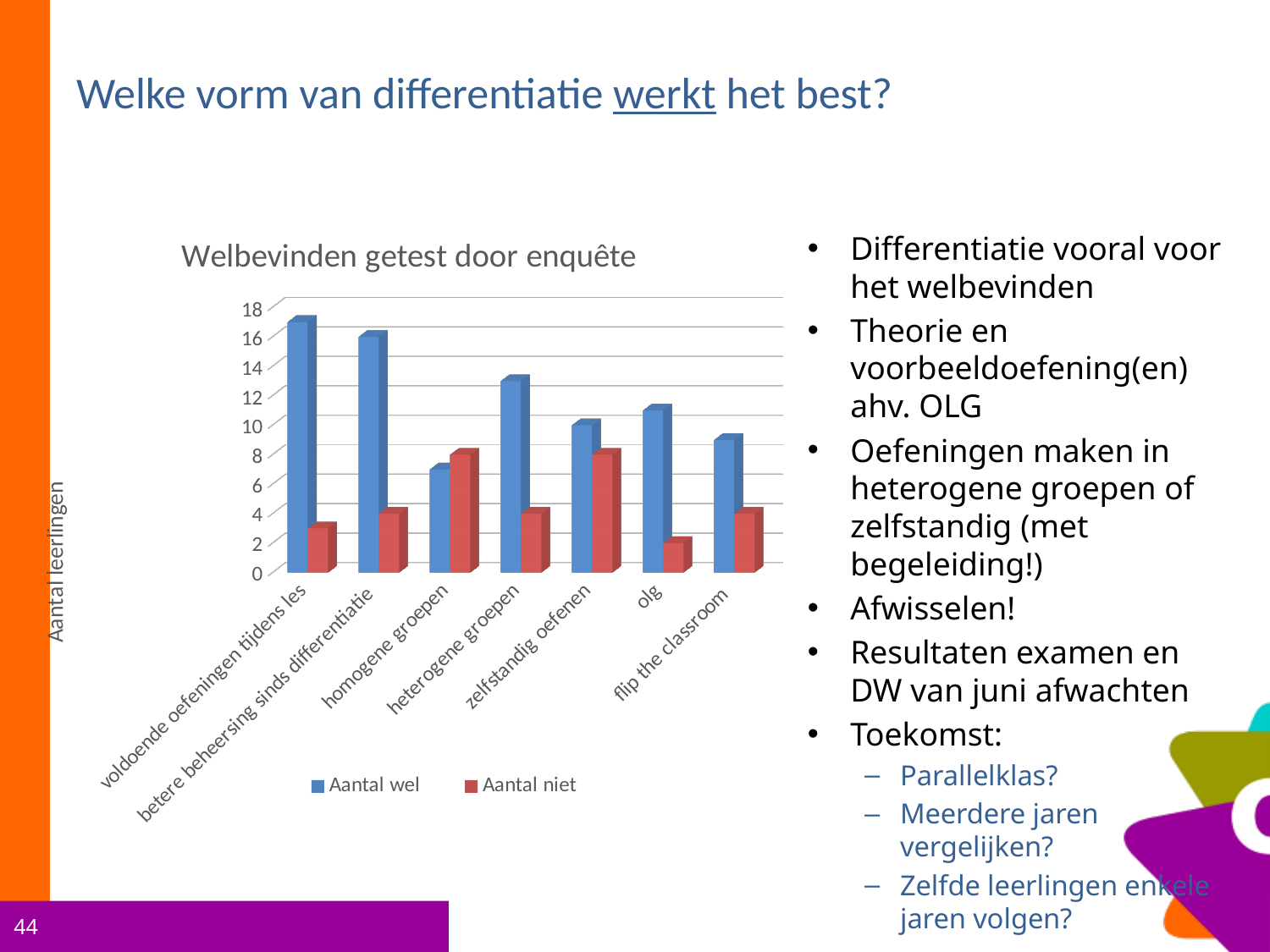
Which category has the lowest value for Aantal wel? homogene groepen Is the Aantal wel value for heterogene groepen greater or less than 10? greater Which category has the lowest value for Aantal niet? olg How many categories are shown on the x axis of the chart? 7 Is the Aantal wel value for voldoende oefeningen tijdens les greater or less than 14? greater How many series does the chart legend list? 2 For olg, which series has the larger value, Aantal wel or Aantal niet? Aantal wel What is the title of the chart? Welbevinden getest door enquête Is the Aantal wel value for homogene groepen greater or less than 8? less What kind of chart is shown on the slide? bar chart Which series is shown in blue in the chart? Aantal wel